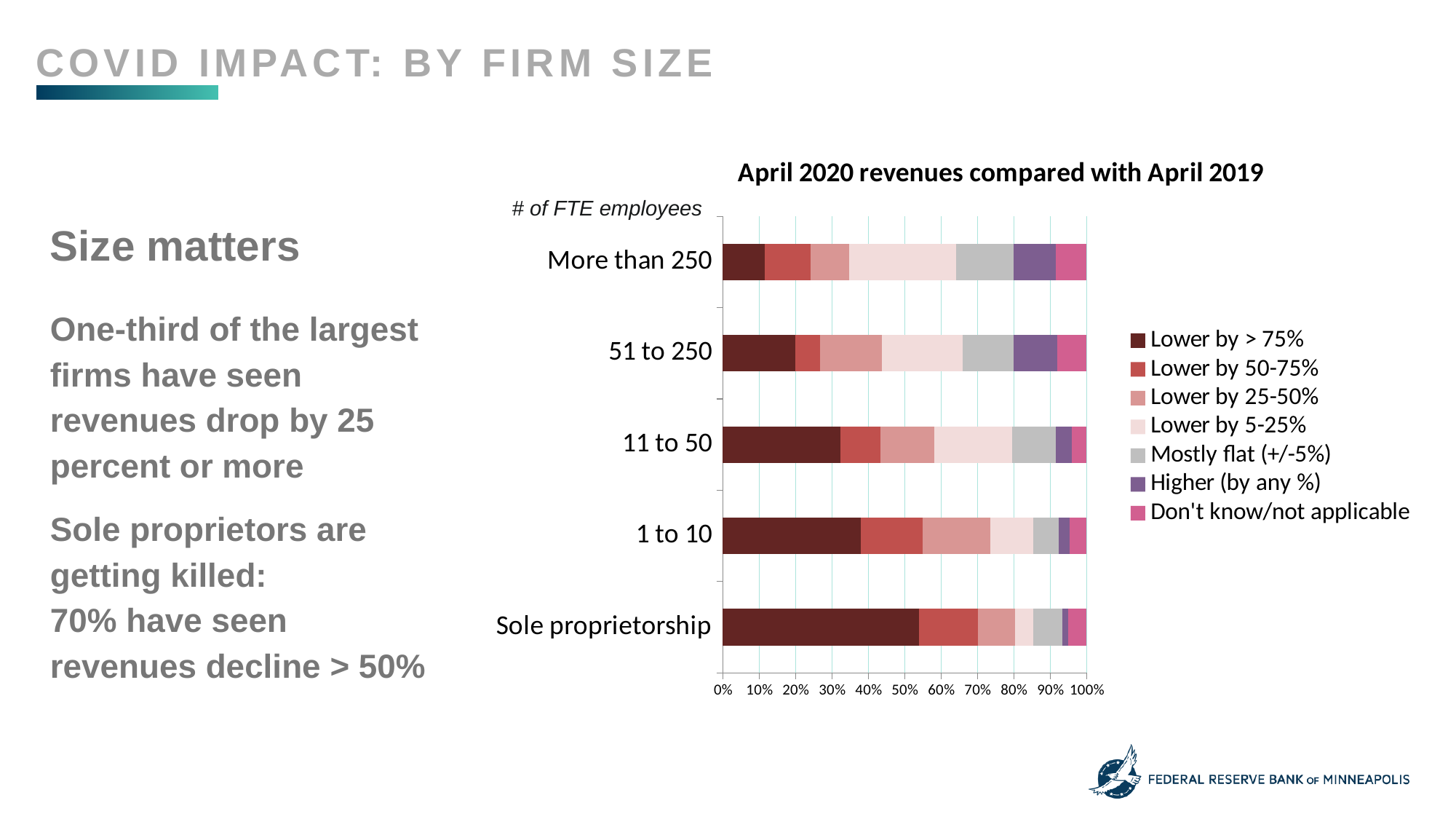
What kind of chart is shown on the slide? Stacked bar chart Is the 'Lower by > 75%' share for firms with 1 to 10 employees greater or less than 30%? greater Moving down the chart from 'More than 250' to 'Sole proprietorship', does the 'Lower by > 75%' share rise or fall? rise What is the title of the chart? April 2020 revenues compared with April 2019 What label is shown above the category axis of the chart? # of FTE employees Which has the larger 'Higher (by any %)' share: firms with more than 250 employees or sole proprietorships? More than 250 Is the 'Lower by > 75%' share for Sole proprietorship greater or less than 50%? greater How many firm-size categories are plotted on the chart? 5 Which firm-size category has the smallest 'Lower by > 75%' share? More than 250 Which firm-size category has the largest 'Lower by > 75%' share? Sole proprietorship Is the 'Lower by > 75%' share for firms with more than 250 employees greater or less than 20%? less How many series does the chart's legend list? 7